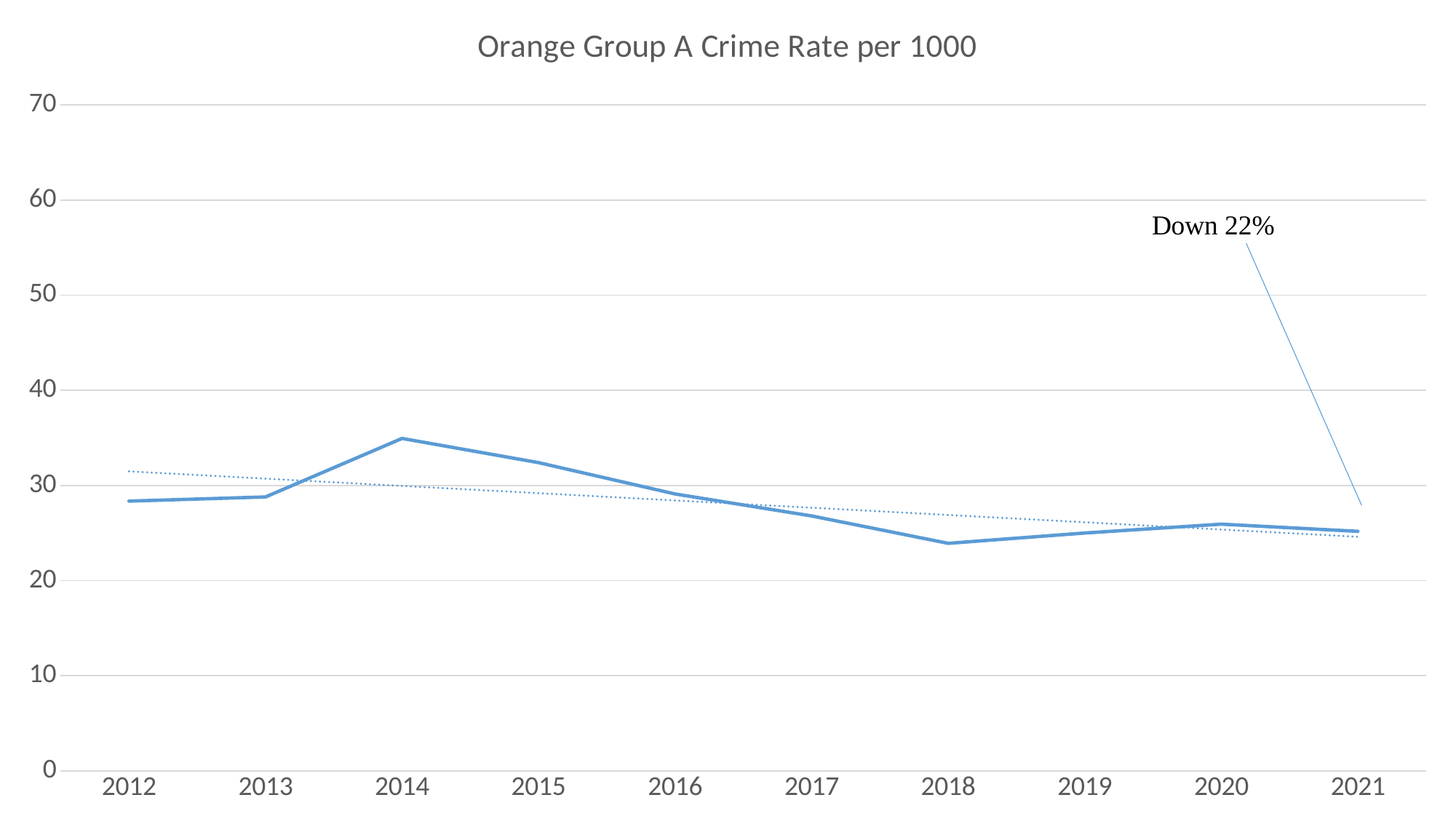
Is the value for 2014 greater or less than 40? less Which year has the larger value, 2014 or 2018? 2014 Is the value for 2018 greater or less than 30? less How many years are plotted along the x axis? 10 Which year has the lowest crime rate? 2018 Is the value for 2014 greater or less than 30? greater Does the crime rate generally rise or fall from 2014 to 2021? fall Which year has the highest crime rate? 2014 What does the annotation on the chart say? Down 22% What kind of chart is shown on the slide? line chart What is the title of the chart? Orange Group A Crime Rate per 1000